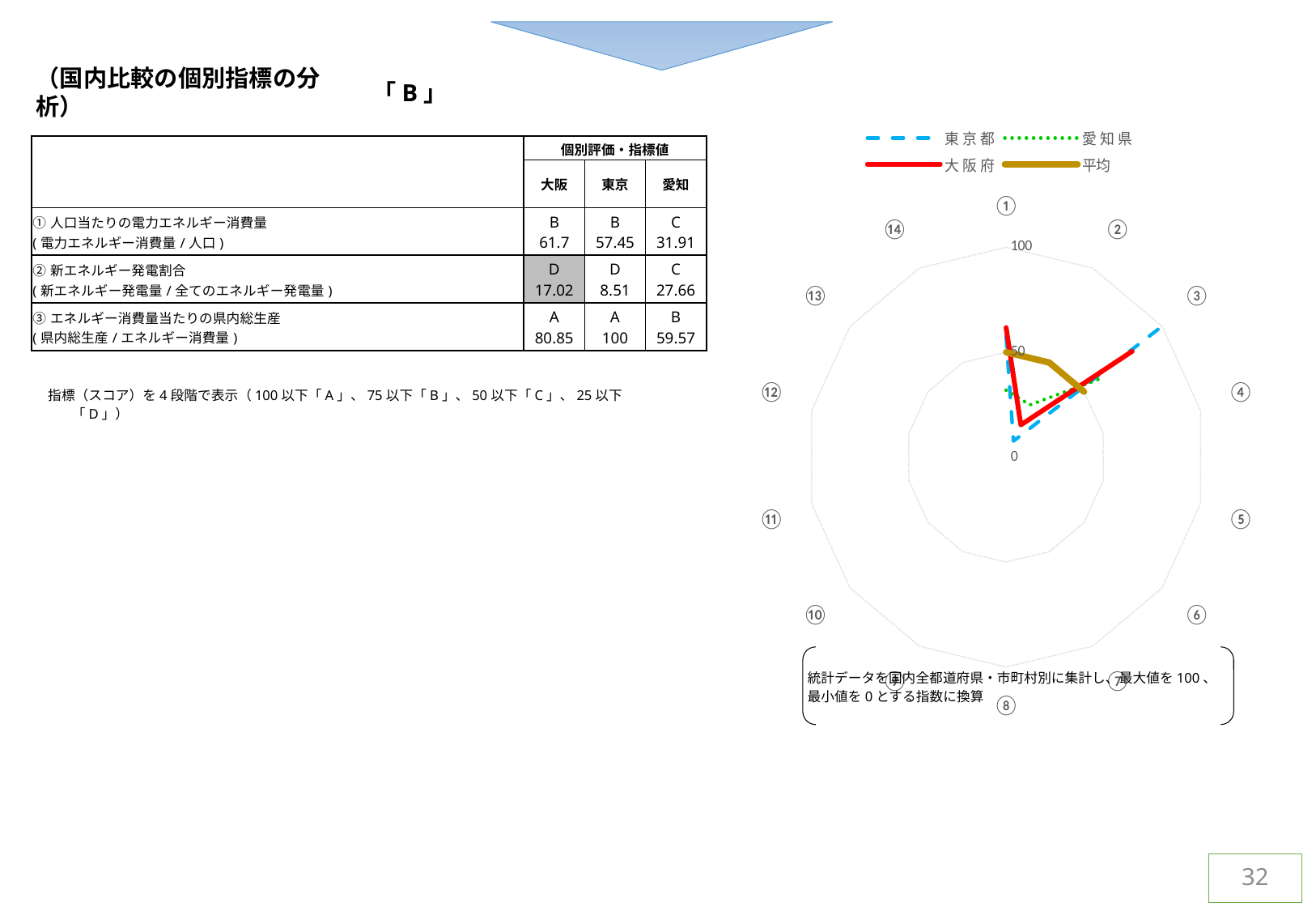
What is the minimum value shown on the radar chart's scale? 0 In the radar chart, is the value for 大阪府 on axis ① greater or less than 50? greater In the radar chart, on axis ①, which series has the larger value, 大阪府 or 愛知県? 大阪府 Which series in the radar chart is drawn with a green dotted line? 愛知県 In the radar chart, is the value for 愛知県 on axis ① greater or less than 50? less What is the maximum value shown on the radar chart's scale? 100 How many numbered axes does the radar chart have? 14 How many series does the legend of the radar chart list? 4 Which series in the radar chart is drawn with a red solid line? 大阪府 What kind of chart is shown on the right side of the slide? radar chart In the radar chart, is the value for 東京都 on axis ③ greater or less than 50? greater In the radar chart, on axis ③, which series has the larger value, 東京都 or 大阪府? 東京都